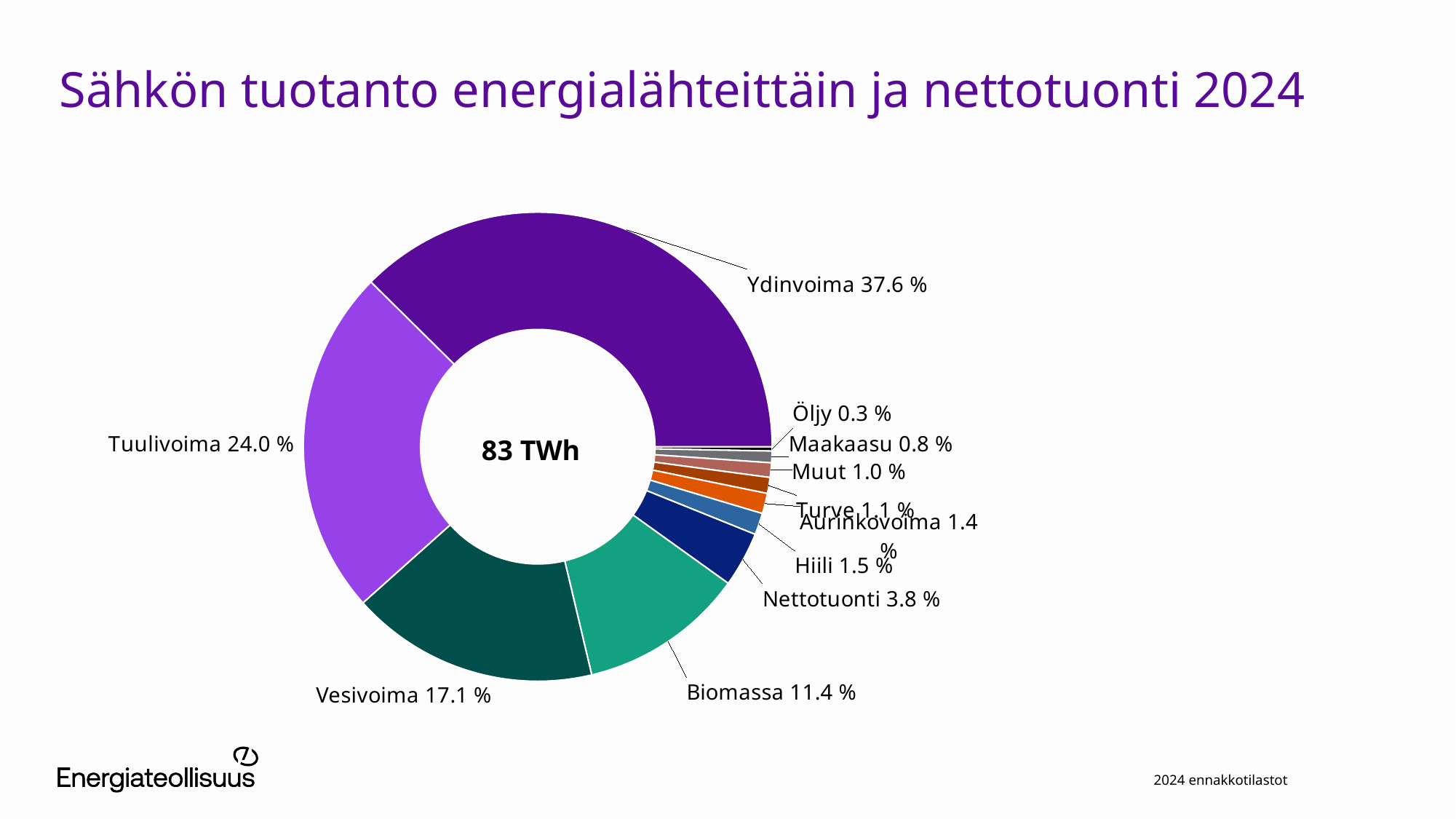
What is the share of Nettotuonti? 3.8 % What kind of chart is shown on the slide? Doughnut (pie) chart Which is larger, the share of Hiili or the share of Aurinkovoima? Hiili Which category has the smallest share in the chart? Öljy What is the difference in percentage points between Ydinvoima and Tuulivoima? 13.6 What percentage is labelled for Vesivoima? 17.1 % How many categories are shown in the chart? 11 What total is printed in the centre of the chart? 83 TWh What is the value shown for Tuulivoima? 24.0 % What share of electricity production does Ydinvoima have in the chart? 37.6 % What is the difference between the shares of Vesivoima and Biomassa? 5.7 % Which energy source has the largest share in the chart? Ydinvoima